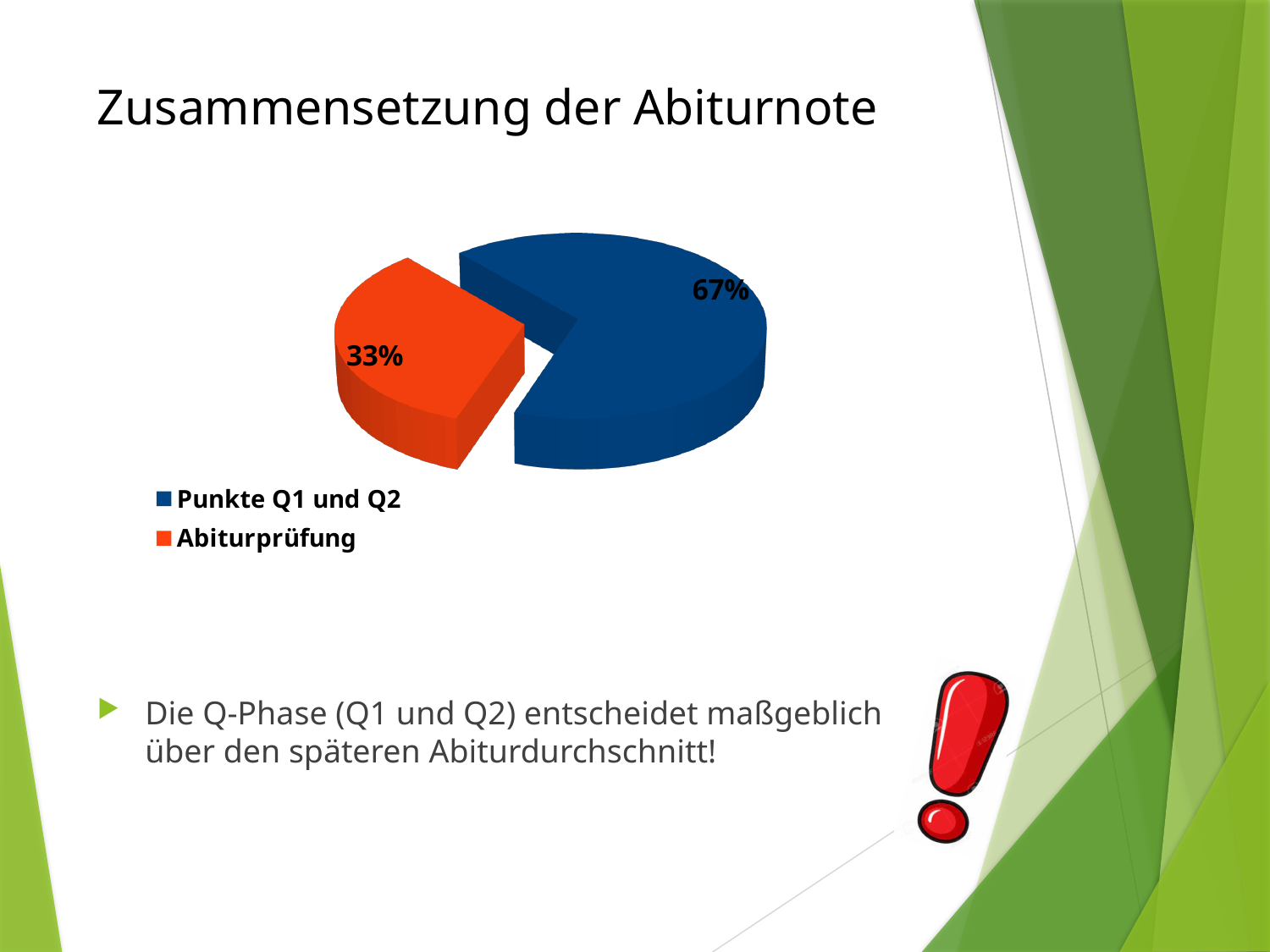
Which is larger, the "Punkte Q1 und Q2" slice or the "Abiturprüfung" slice? Punkte Q1 und Q2 What kind of chart is shown on the slide? pie chart How many slices does the pie chart have? 2 Which slice is the largest? Punkte Q1 und Q2 What colour is the "Punkte Q1 und Q2" slice? blue What share of the pie does "Abiturprüfung" have? 33% How many entries does the legend list? 2 What colour is the "Abiturprüfung" slice? orange Which slice is the smallest? Abiturprüfung What share of the pie does "Punkte Q1 und Q2" have? 67% What is the difference in percentage points between the "Punkte Q1 und Q2" slice and the "Abiturprüfung" slice? 34